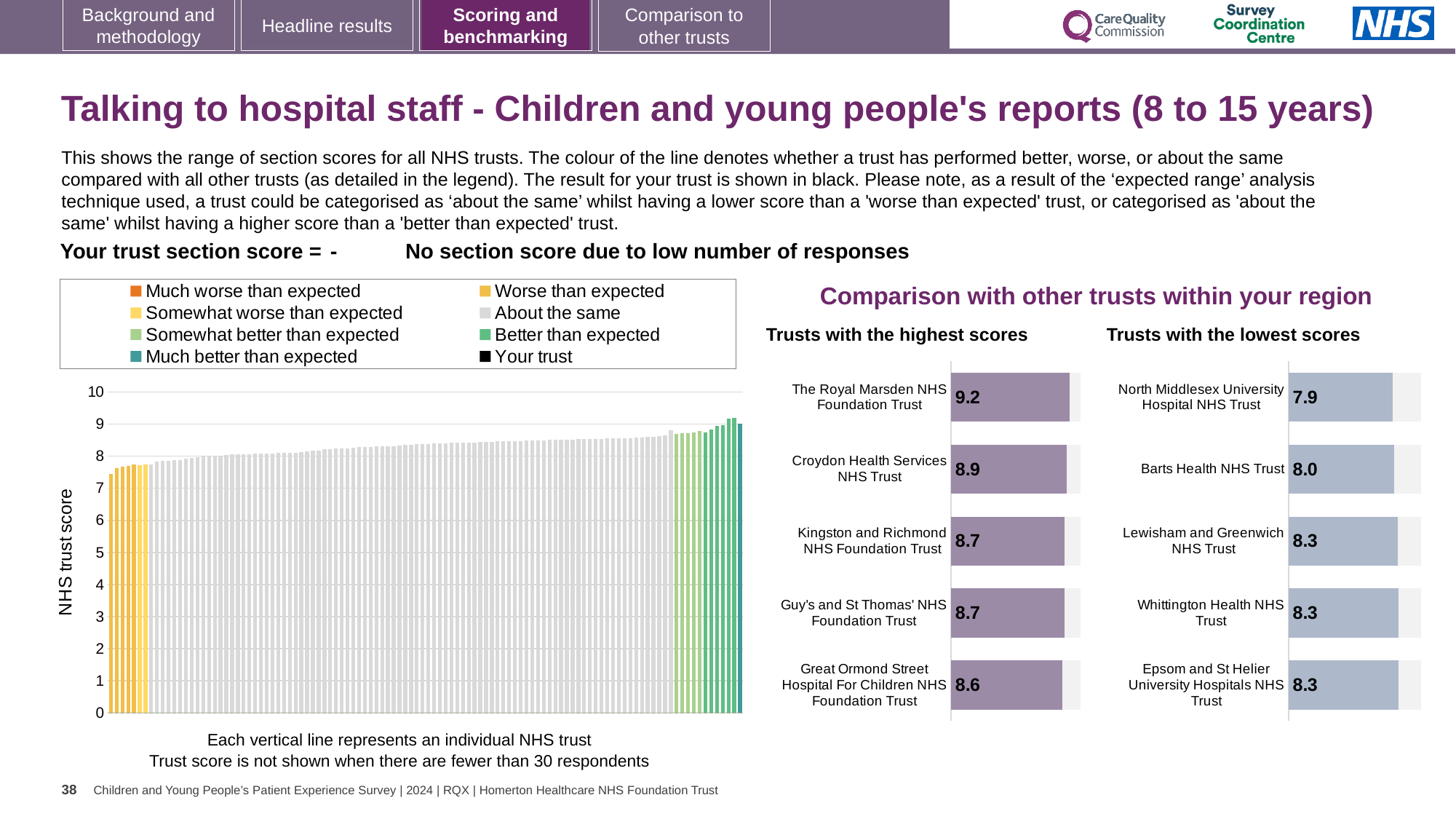
In the 'Trusts with the lowest scores' chart, which trust has the lowest score? North Middlesex University Hospital NHS Trust What kind of chart is the large chart on the left with the 'NHS trust score' axis? Bar chart In the large 'NHS trust score' chart, do the bar values rise or fall from left to right? Rise In the 'Trusts with the lowest scores' chart, what is the score for Barts Health NHS Trust? 8.0 In the 'Trusts with the highest scores' chart, what is the score for The Royal Marsden NHS Foundation Trust? 9.2 In the 'Trusts with the highest scores' chart, what is the score for Croydon Health Services NHS Trust? 8.9 In the 'Trusts with the highest scores' chart, which trust has the highest score? The Royal Marsden NHS Foundation Trust Which is larger: the score for Croydon Health Services NHS Trust in the 'Trusts with the highest scores' chart or the score for Barts Health NHS Trust in the 'Trusts with the lowest scores' chart? Croydon Health Services NHS Trust How many trusts are shown in the 'Trusts with the lowest scores' chart? 5 In the 'Trusts with the lowest scores' chart, what is the score for North Middlesex University Hospital NHS Trust? 7.9 How many entries does the legend of the large 'NHS trust score' chart list? 8 In the 'Trusts with the highest scores' chart, what is the difference between the scores of The Royal Marsden NHS Foundation Trust and Great Ormond Street Hospital For Children NHS Foundation Trust? 0.6